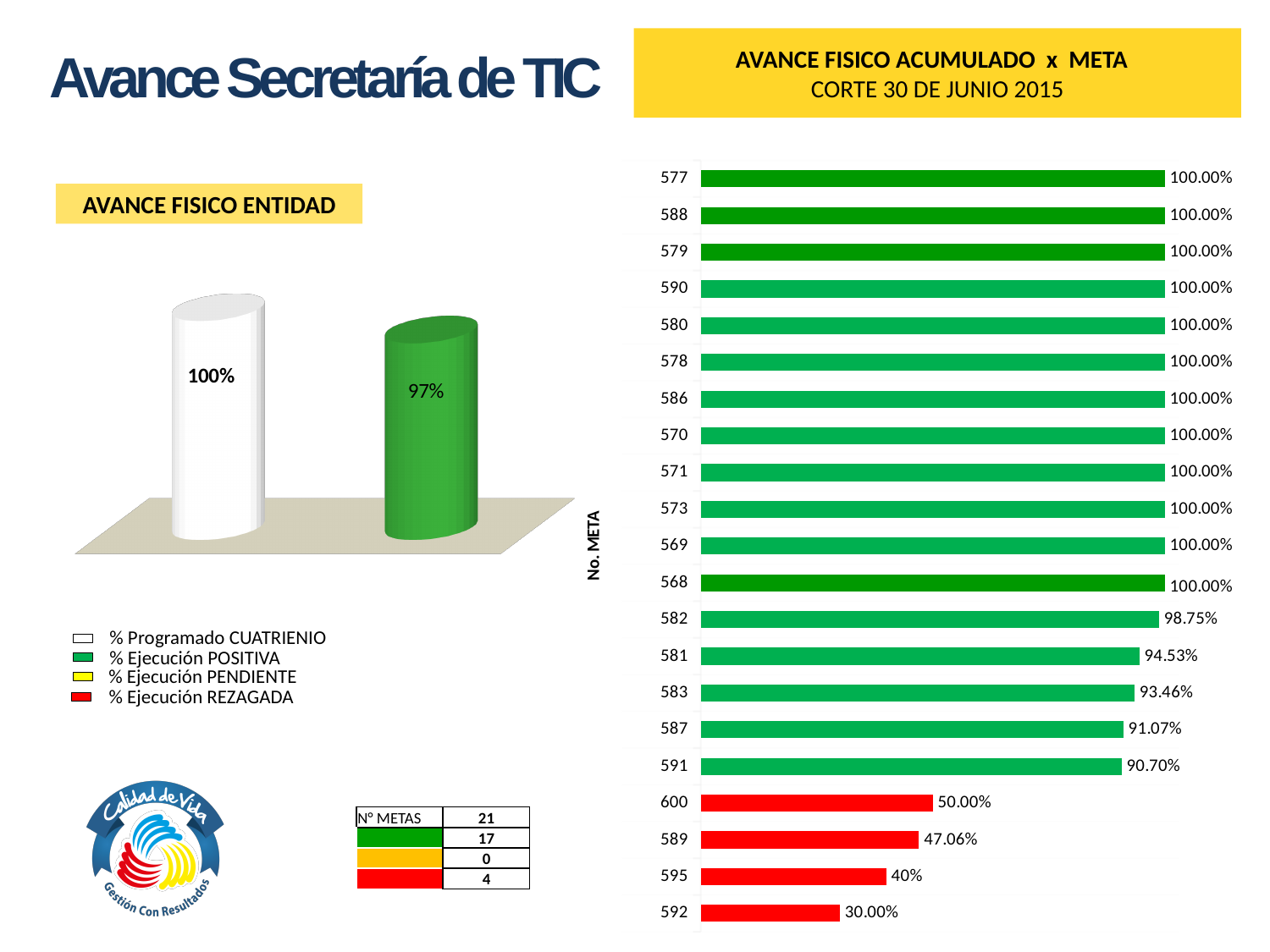
In the AVANCE FISICO ACUMULADO x META chart, which is larger, the value for meta 581 or the value for meta 583? 581 In the AVANCE FISICO ACUMULADO x META chart, how many metas have a value of 100.00%? 12 How many entries does the legend of the AVANCE FISICO ENTIDAD chart list? 4 What kind of chart is the AVANCE FISICO ACUMULADO x META chart? bar chart In the AVANCE FISICO ACUMULADO x META chart, what is the value for meta 591? 90.70% In the AVANCE FISICO ENTIDAD chart, what is the value for % Programado CUATRIENIO? 100% In the AVANCE FISICO ENTIDAD chart, what is the value for % Ejecución POSITIVA? 97% In the AVANCE FISICO ACUMULADO x META chart, how many metas are plotted? 21 In the AVANCE FISICO ACUMULADO x META chart, what is the value for meta 589? 47.06% In the AVANCE FISICO ACUMULADO x META chart, what is the value for meta 582? 98.75% In the AVANCE FISICO ACUMULADO x META chart, which meta has the lowest value? 592 In the AVANCE FISICO ACUMULADO x META chart, what is the difference between the values for meta 600 and meta 592? 20.00%